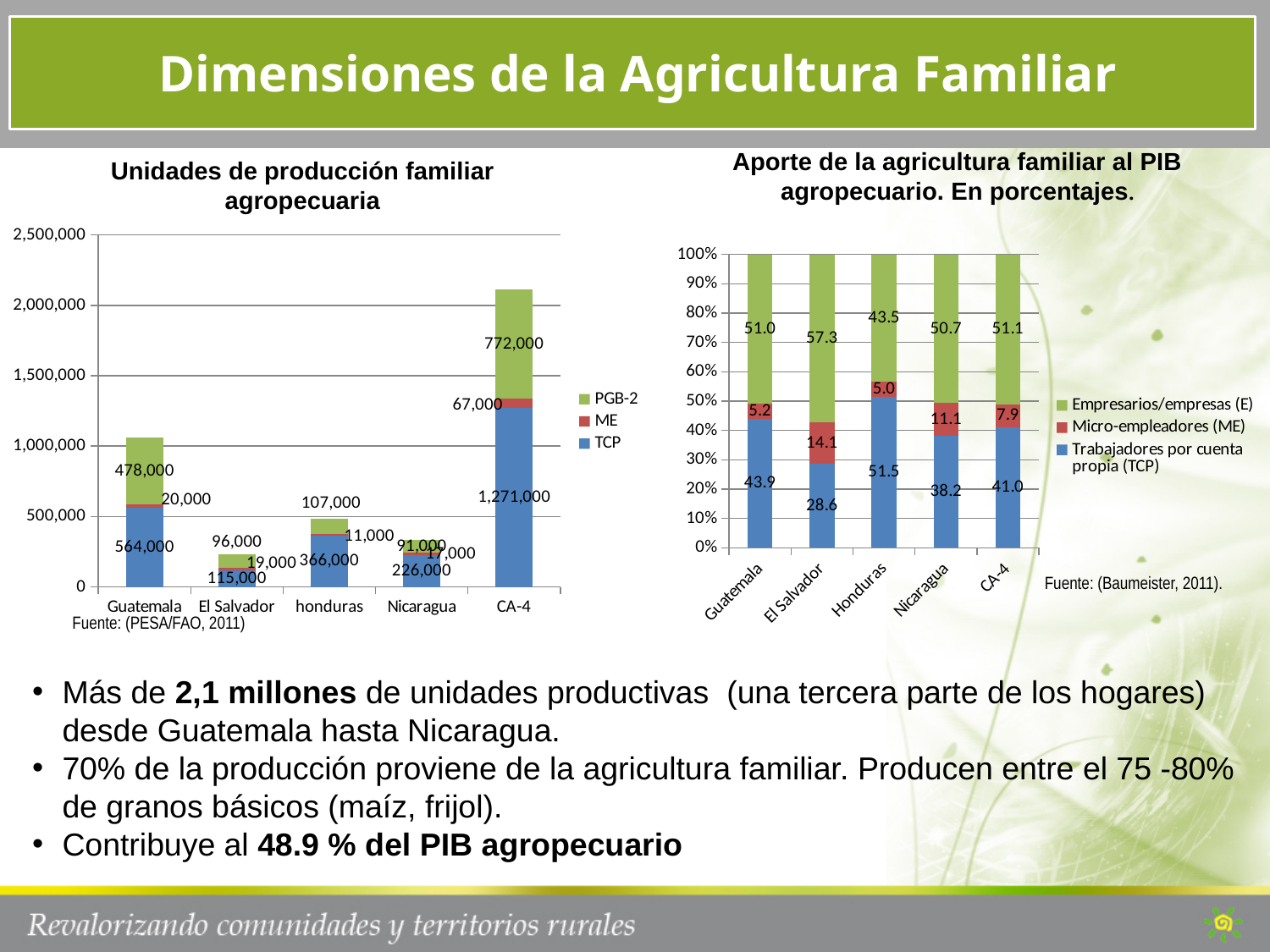
In the chart 'Aporte de la agricultura familiar al PIB agropecuario', what is the Micro-empleadores (ME) value for El Salvador? 14.1 In the chart 'Aporte de la agricultura familiar al PIB agropecuario', which country has the highest Empresarios/empresas (E) value? El Salvador In the chart 'Unidades de producción familiar agropecuaria', which category has the tallest stacked bar? CA-4 In the chart 'Unidades de producción familiar agropecuaria', what is the TCP value for Guatemala? 564,000 What kind of chart is 'Aporte de la agricultura familiar al PIB agropecuario'? Stacked bar chart In the chart 'Aporte de la agricultura familiar al PIB agropecuario', is the Micro-empleadores (ME) value larger for Nicaragua or for CA-4? Nicaragua In the chart 'Unidades de producción familiar agropecuaria', what is the ME value for honduras? 11,000 In the chart 'Aporte de la agricultura familiar al PIB agropecuario', what is the Trabajadores por cuenta propia (TCP) value for Honduras? 51.5 In the chart 'Unidades de producción familiar agropecuaria', what is the PGB-2 value for CA-4? 772,000 In the chart 'Unidades de producción familiar agropecuaria', which category has the shortest stacked bar? El Salvador In the chart 'Unidades de producción familiar agropecuaria', how many series does the legend list? 3 In the chart 'Unidades de producción familiar agropecuaria', what is the difference between the TCP values for Guatemala and honduras? 198,000